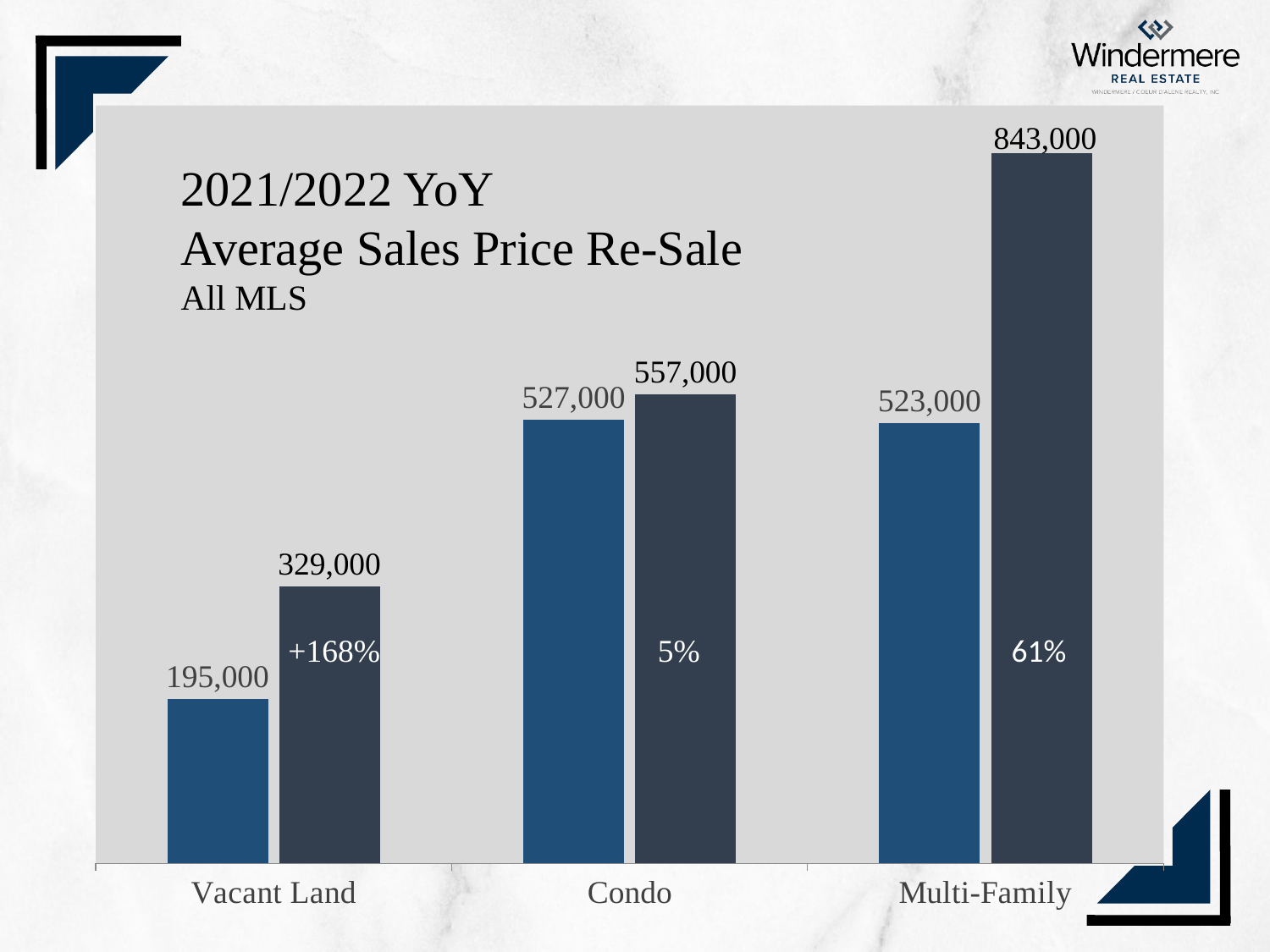
What is the value of the lighter blue bar for Condo? 527,000 What percentage label is printed on the darker bar for Vacant Land? +168% What kind of chart is shown on the slide? Bar chart What is the value of the darker bar for Multi-Family? 843,000 Which category has the lowest bar on the chart? Vacant Land How many categories are shown on the x axis? 3 What is the difference between the darker bar and the lighter blue bar for Multi-Family? 320,000 Which category has the highest bar on the chart? Multi-Family What is the value of the lighter blue bar for Vacant Land? 195,000 What is the value of the darker bar for Condo? 557,000 What is the difference between the darker bar and the lighter blue bar for Vacant Land? 134,000 Which is larger: the lighter blue bar for Condo or the lighter blue bar for Multi-Family? Condo